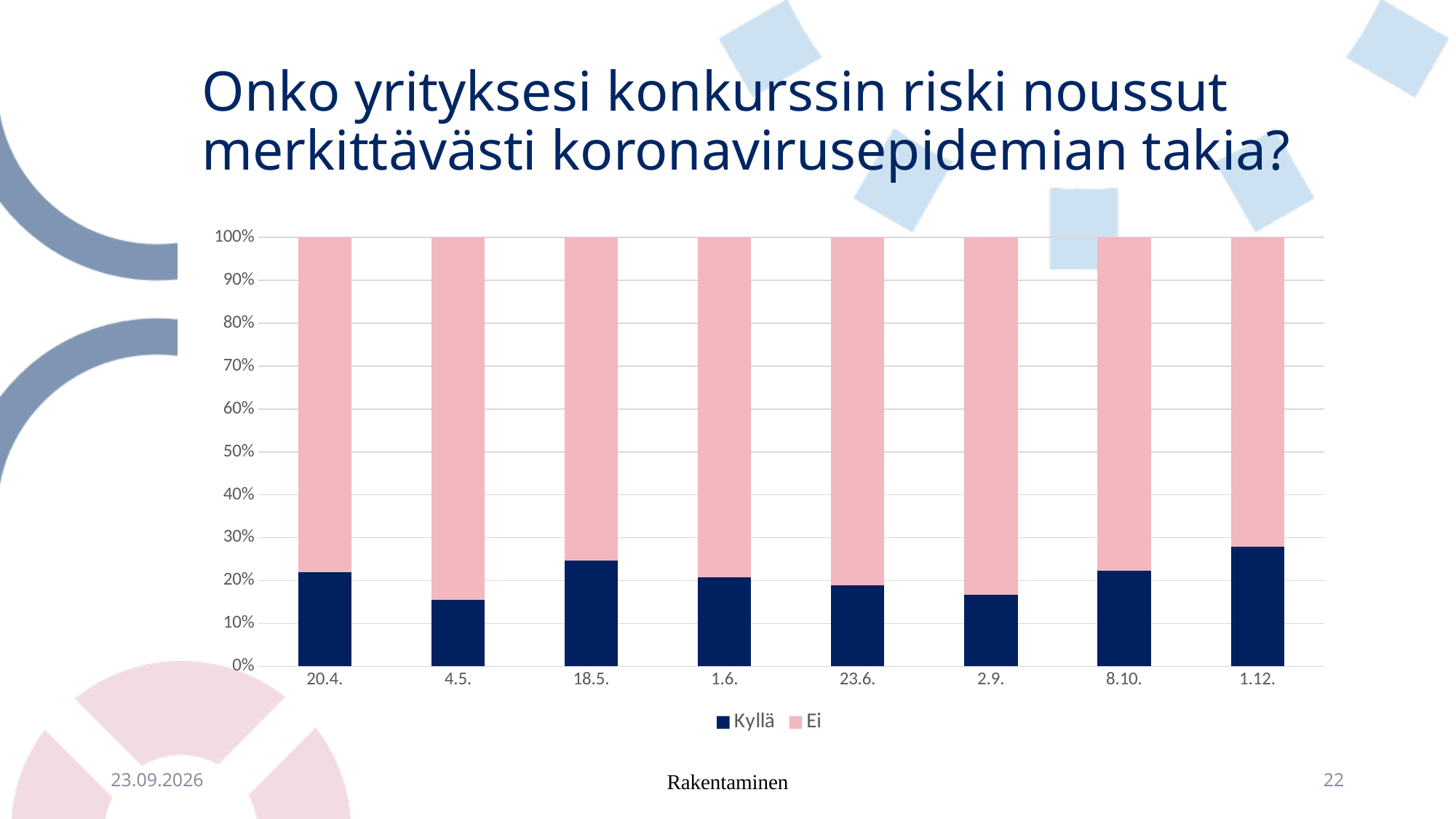
Which has the larger Kyllä share, 1.12. or 4.5.? 1.12. What are the two series named in the legend? Kyllä and Ei Is the Kyllä value for 4.5. greater or less than 20%? less On which date is the Kyllä share the highest? 1.12. What kind of chart is shown on the slide? bar chart Is the Kyllä value for 18.5. greater or less than 20%? greater How many dates (categories) are shown on the x axis? 8 How many series does the legend list? 2 Is the Kyllä value for 1.12. greater or less than 20%? greater Which colour represents the Kyllä series? dark blue What is the total of the stacked bar for 20.4.? 100%